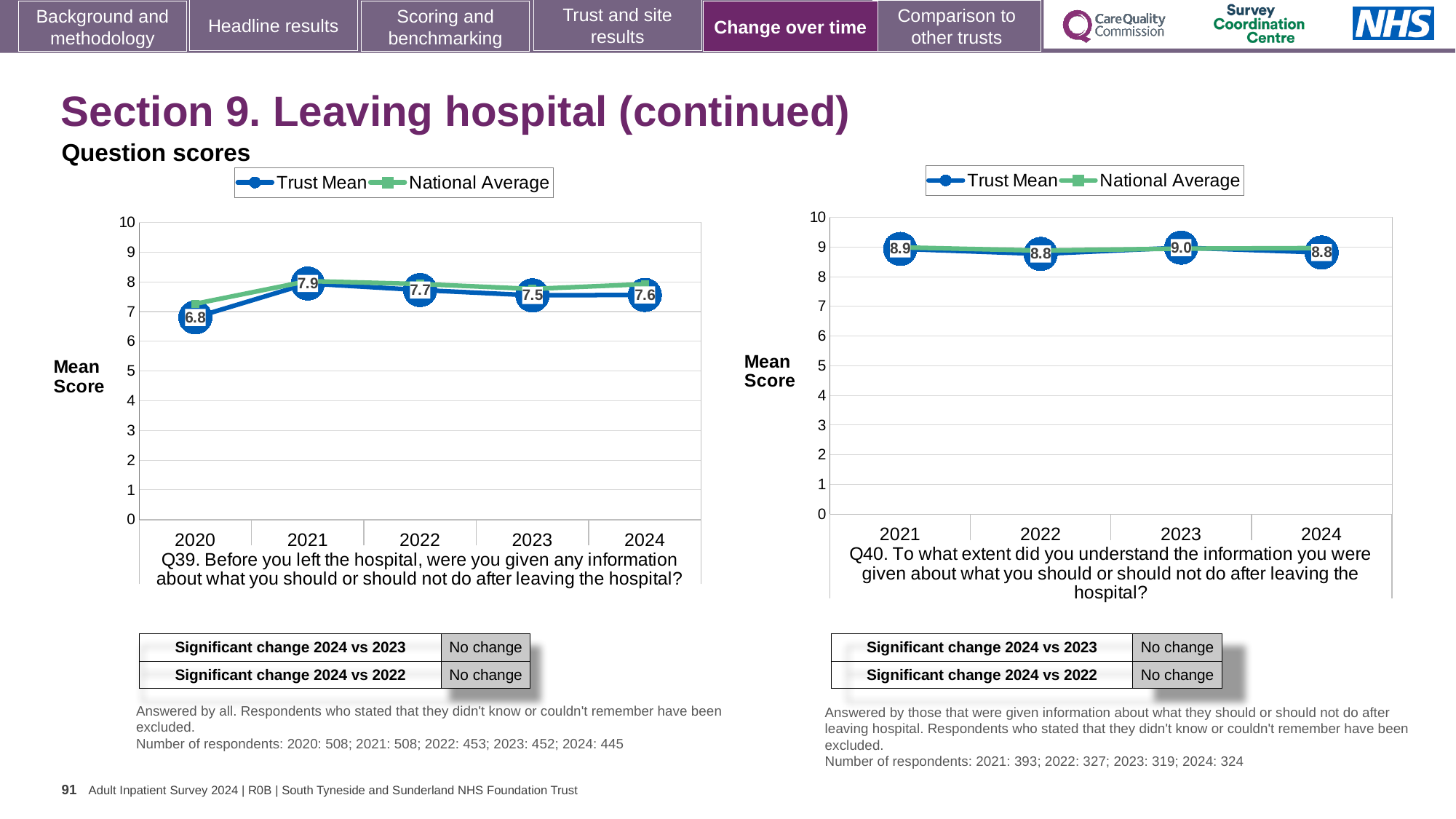
On the Q39 chart (left), what is the Trust Mean score for 2024? 7.6 On the Q39 chart (left), what is the Trust Mean score for 2020? 6.8 On the Q40 chart (right), what is the Trust Mean score for 2023? 9.0 On the Q40 chart (right), what is the Trust Mean score for 2022? 8.8 On the Q39 chart (left), which year has the highest Trust Mean score? 2021 On the Q39 chart (left), what is the difference between the Trust Mean scores for 2021 and 2020? 1.1 On the Q39 chart (left), how many years are plotted on the x axis? 5 On the Q39 chart (left), which year has the lowest Trust Mean score? 2020 On the Q40 chart (right), which year has the highest Trust Mean score? 2023 On the Q40 chart (right), is the Trust Mean score for 2021 greater or less than 8? greater How many series does the legend of the Q40 chart (right) list? 2 What kind of chart is the Q39 chart (left)? Line chart